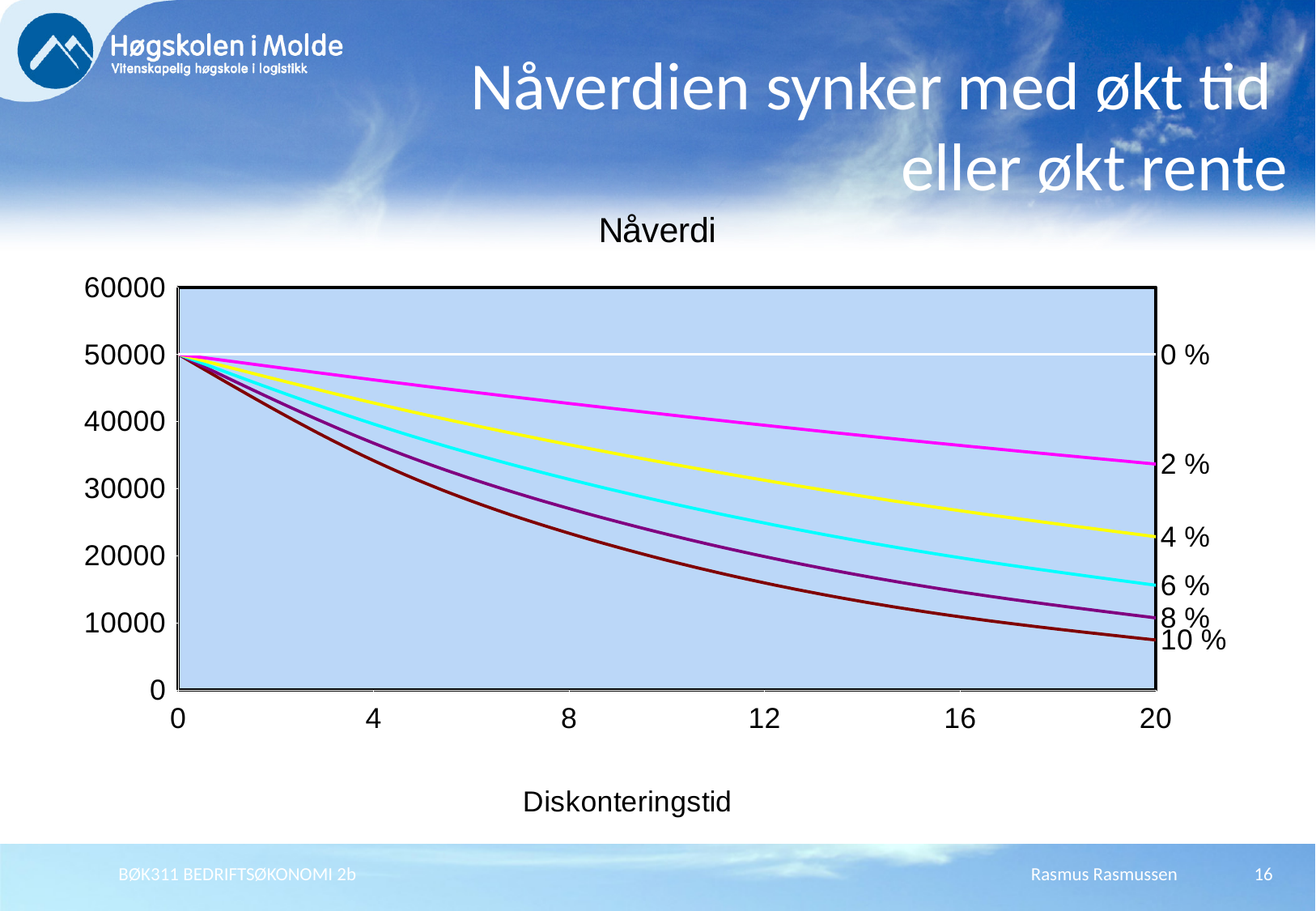
Which interest-rate line has the lowest value at Diskonteringstid 20? 10 % Is the value of the 10 % line at Diskonteringstid 20 greater or less than 10000? less At Diskonteringstid 20, which line has the larger value, 2 % or 10 %? 2 % Is the value of the 2 % line at Diskonteringstid 20 greater or less than 30000? greater How many interest-rate lines are plotted on the chart? 6 What value do all the lines start from at Diskonteringstid 0? 50000 What is the title of the x axis? Diskonteringstid What is the value of the 0 % line at Diskonteringstid 20? 50000 Is the value of the 6 % line at Diskonteringstid 20 greater or less than 20000? less What kind of chart is shown on the slide? line chart Does the 0 % line rise, fall or stay constant as Diskonteringstid increases? stay constant Does the 10 % line rise or fall as Diskonteringstid increases? fall